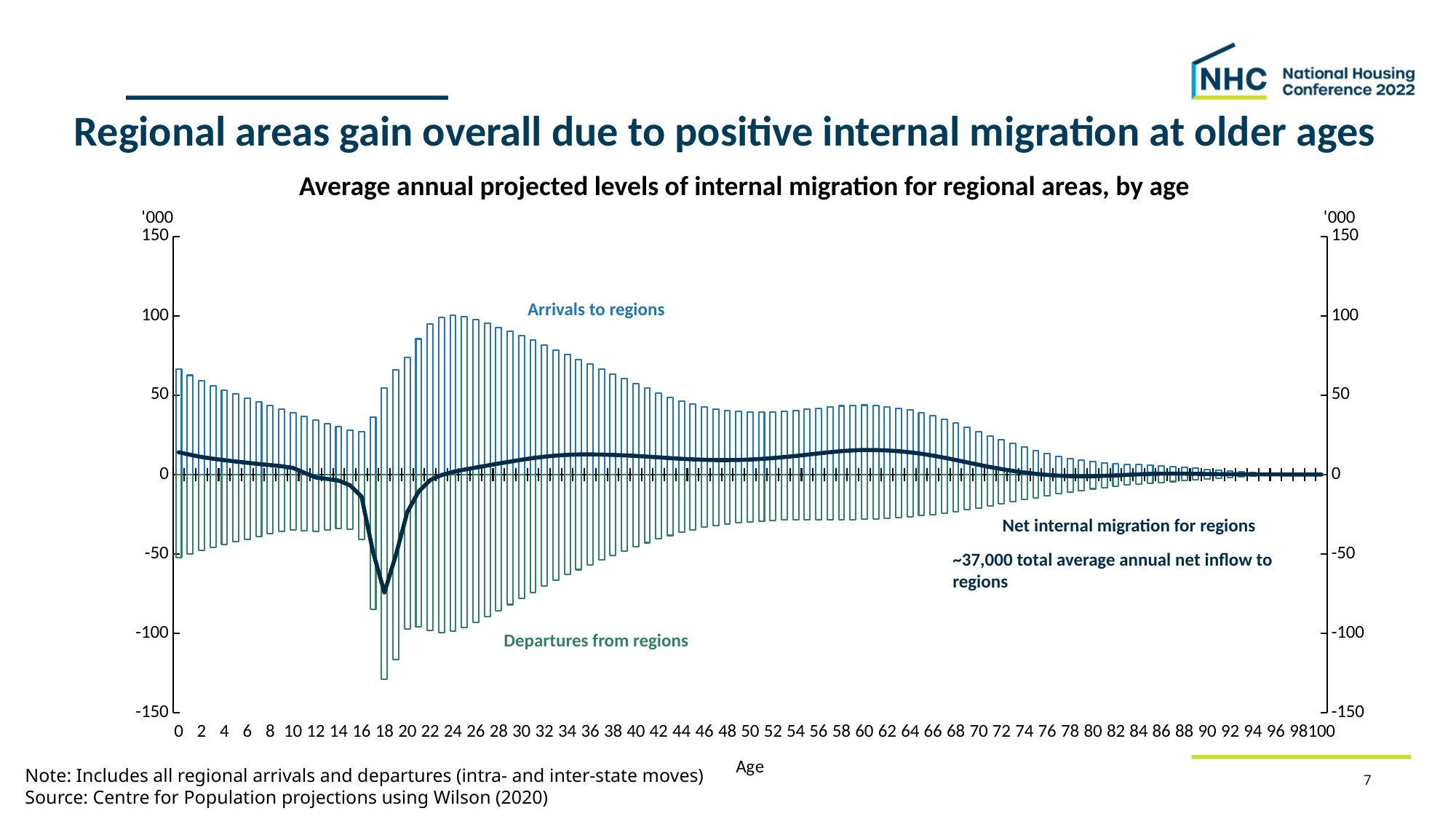
Is the value for Departures from regions at age 18 greater or less than -100? less Is the value for Arrivals to regions at age 60 greater or less than 50? less Is the value for Departures from regions at age 50 greater or less than -50? greater How many series are labelled on the chart? 3 At which age is the value for Departures from regions lowest (most negative)? 18 Do the values for Arrivals to regions rise or fall between age 24 and age 50? fall What kind of chart is shown on the slide? combination bar and line chart Which is larger, Arrivals to regions at age 24 or at age 60? age 24 What is the title of the chart? Average annual projected levels of internal migration for regional areas, by age What unit is shown on the vertical axis of the chart? '000